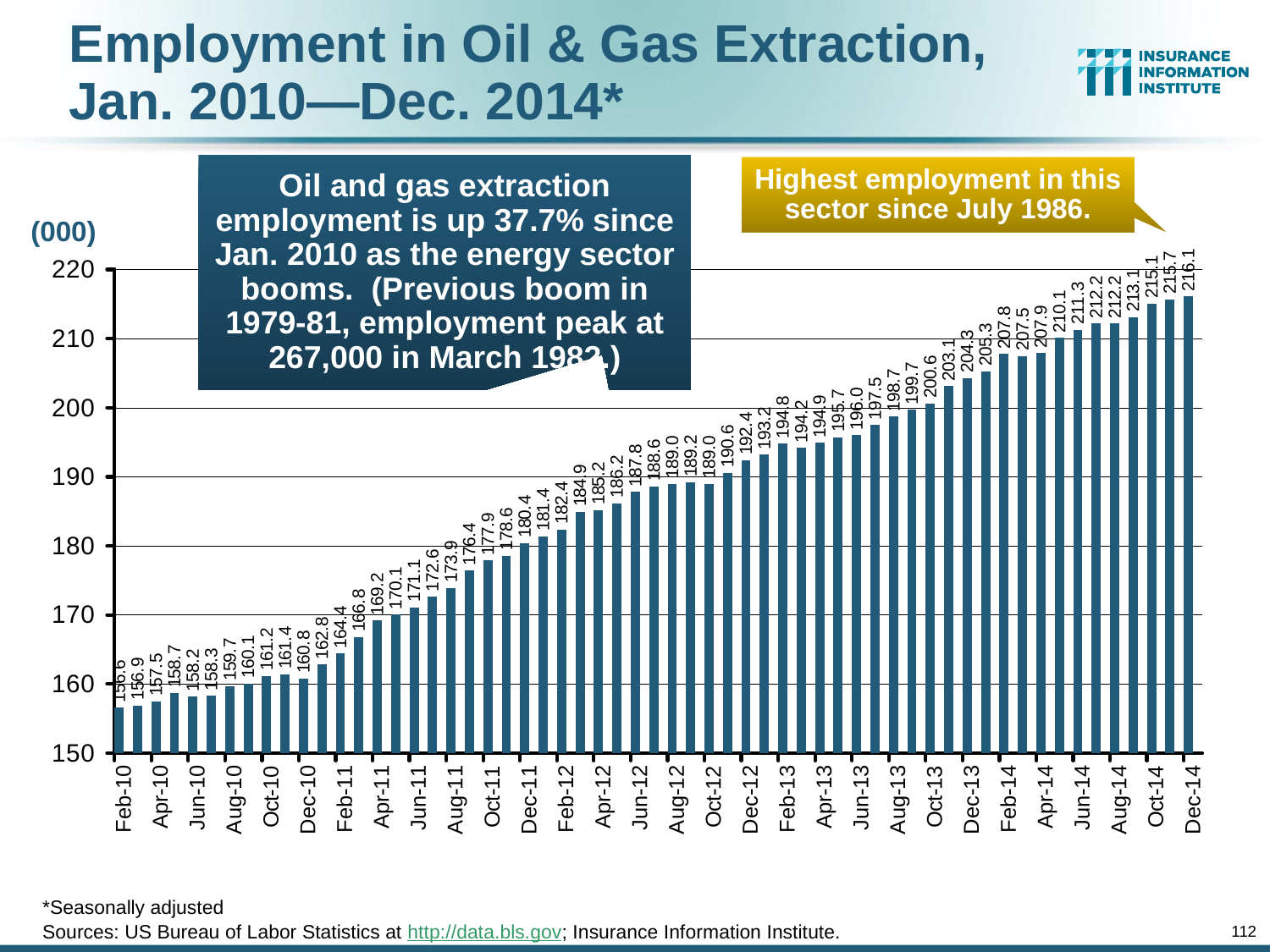
According to the callout, since when has employment in this sector not been this high? July 1986 What type of chart is shown on the slide? Bar chart What is the highest value shown in the chart? 216.1 Which is larger, the value for Dec-14 or the value for Feb-10? Dec-14 Do the values generally rise or fall from left to right along the x axis? Rise What unit is indicated for the y axis values? (000) What is the employment value for Feb-10? 156.6 Which month has the highest employment value in the chart? Dec-14 Is the value for Feb-10 greater or less than 160? less Is the value for Dec-14 greater or less than 210? greater What is the employment value for Dec-14? 216.1 What is the difference between the Dec-14 value and the Feb-10 value? 59.5